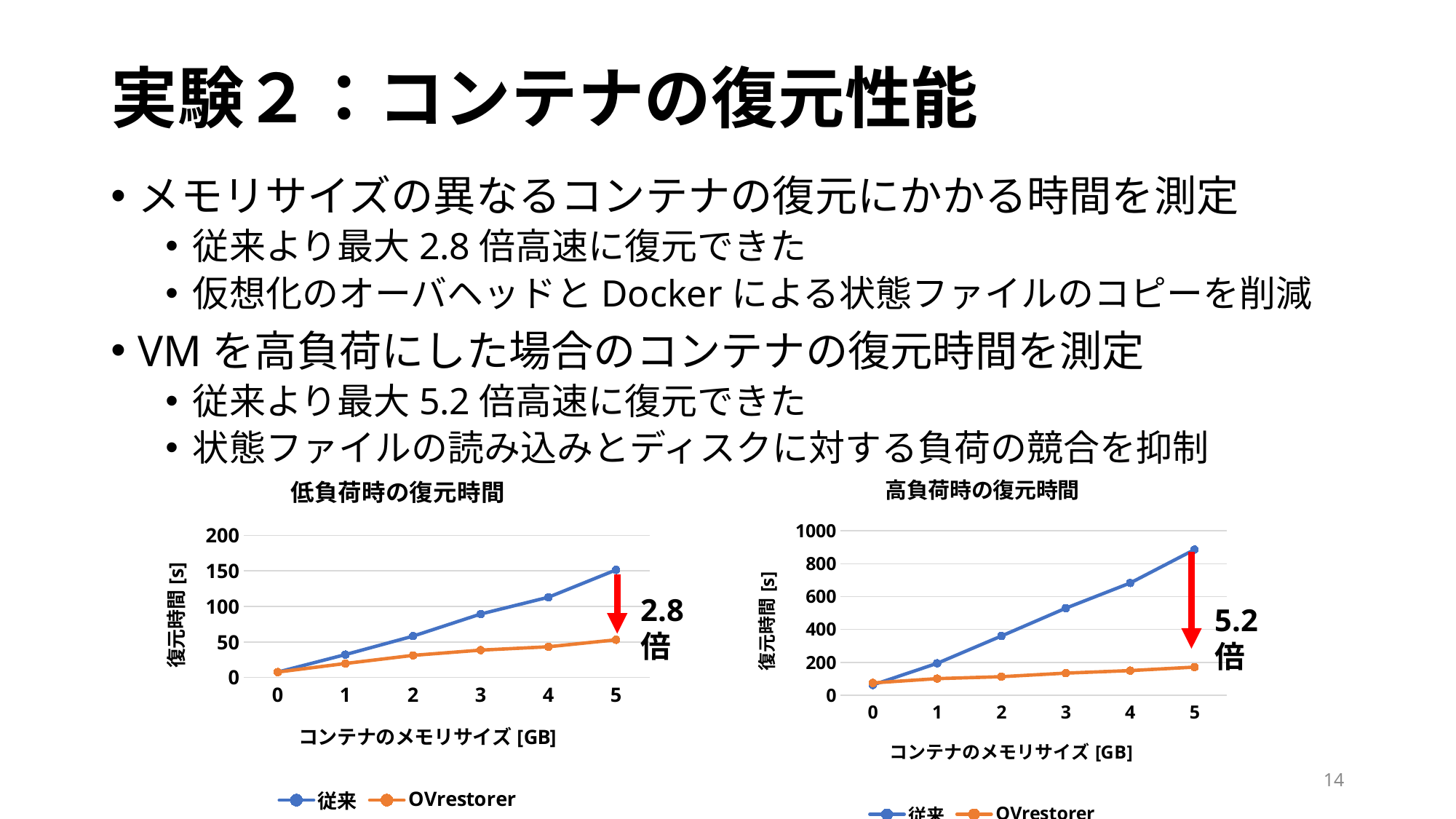
In the left chart (低負荷時の復元時間), is the 従来 value at 5 GB greater or less than 100? greater In the left chart (低負荷時の復元時間), how many memory-size points are plotted along the x axis? 6 In the left chart (低負荷時の復元時間), is the OVrestorer value at 5 GB greater or less than 100? less In the right chart (高負荷時の復元時間), is the 従来 value at 5 GB greater or less than 800? greater What is the title of the right chart? 高負荷時の復元時間 In the right chart (高負荷時の復元時間), does the 従来 line rise or fall as the container memory size increases? rises What type of chart is the left chart titled 低負荷時の復元時間? line chart How many series does the legend of the right chart (高負荷時の復元時間) list? 2 What is the y-axis label of the left chart (低負荷時の復元時間)? 復元時間 [s] In the right chart (高負荷時の復元時間), which series has the larger value at 5 GB, 従来 or OVrestorer? 従来